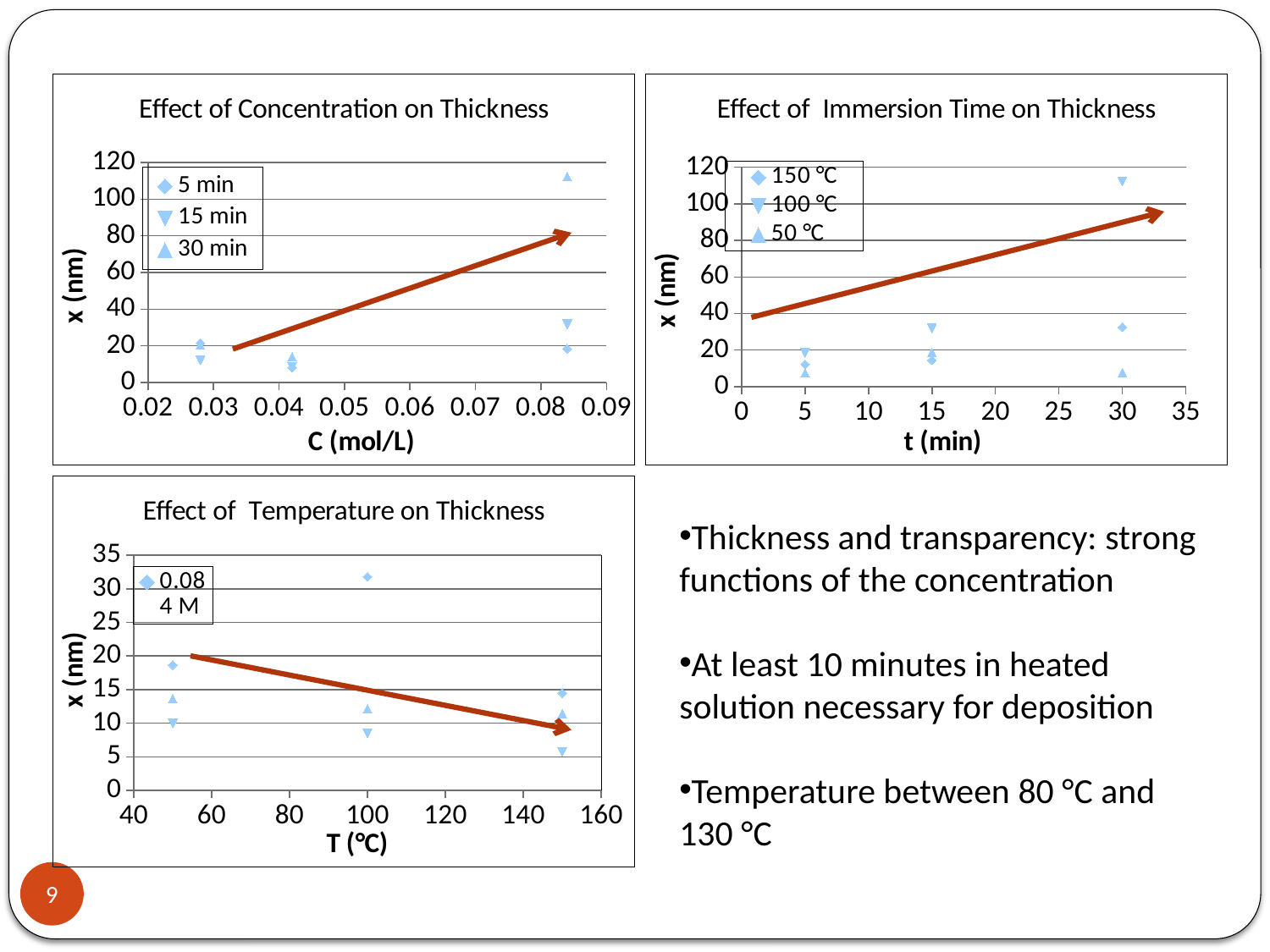
What are the legend entries of the 'Effect of Immersion Time on Thickness' chart? 150 °C, 100 °C, 50 °C What kind of chart is the 'Effect of Concentration on Thickness' chart? Scatter chart In the 'Effect of Concentration on Thickness' chart, does the trend arrow rise or fall as concentration increases? rises In the 'Effect of Temperature on Thickness' chart, is the highest point at T = 100 °C greater or less than 25 nm? greater In the 'Effect of Immersion Time on Thickness' chart, is the 100 °C value at t = 30 min greater or less than 100 nm? greater How many series does the legend of the 'Effect of Immersion Time on Thickness' chart list? 3 In the 'Effect of Temperature on Thickness' chart, does the trend arrow rise or fall as temperature increases? falls What is the x-axis label of the 'Effect of Concentration on Thickness' chart? C (mol/L) How many series does the legend of the 'Effect of Temperature on Thickness' chart list? 1 In the 'Effect of Immersion Time on Thickness' chart, is the 50 °C value at t = 30 min greater or less than 20 nm? less How many series does the legend of the 'Effect of Concentration on Thickness' chart list? 3